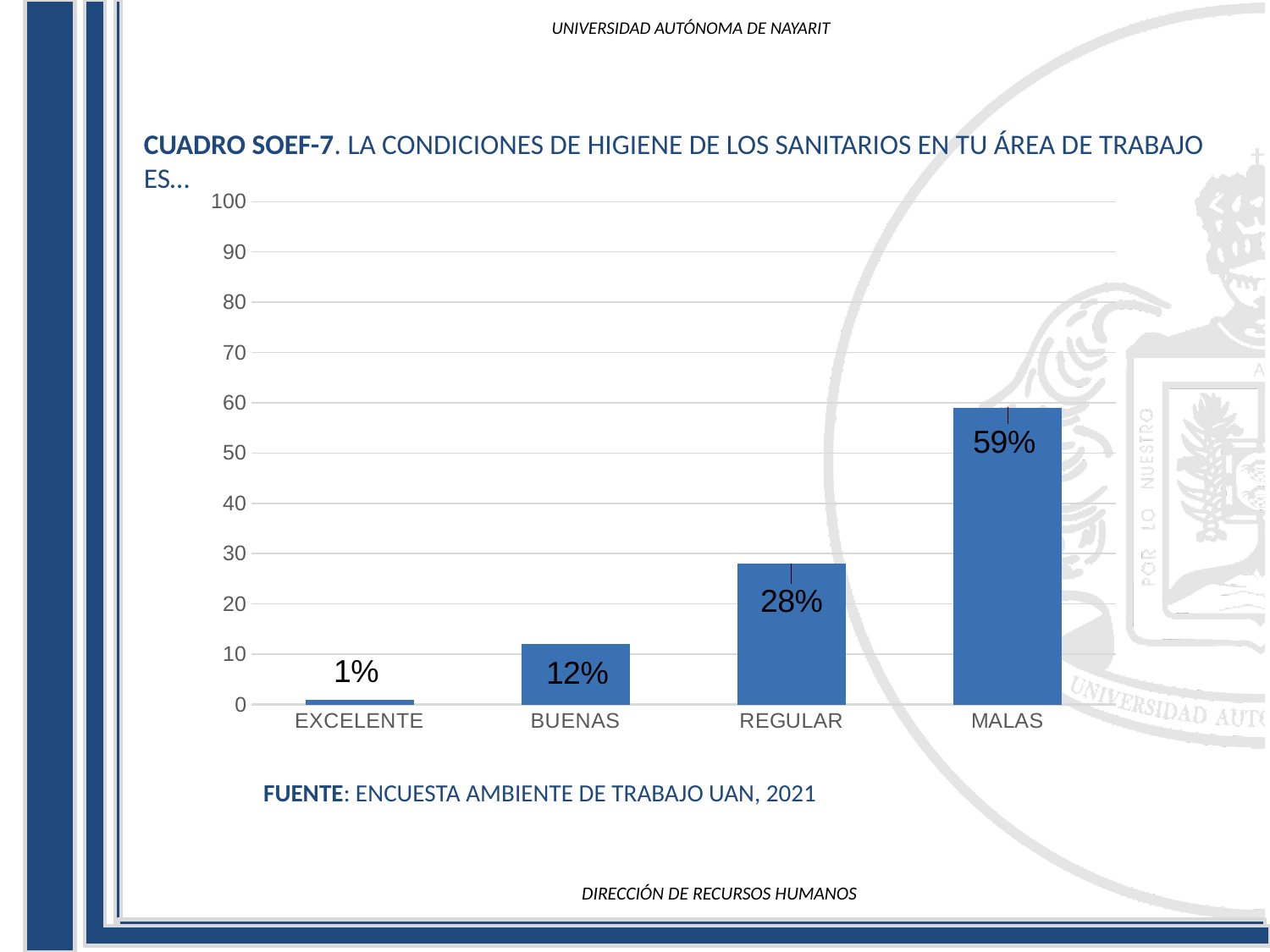
What is the value for BUENAS? 12% Do the values rise or fall from left to right along the x axis? rise How many categories are shown on the x axis? 4 What kind of chart is shown on the slide? bar chart Which is larger, the value for BUENAS or the value for REGULAR? REGULAR Which category has the lowest value? EXCELENTE What is the difference between the values for MALAS and REGULAR? 31% What is the value for REGULAR? 28% Which category has the highest value? MALAS Is the value for MALAS greater or less than 50? greater What is the value for MALAS? 59% What is the value for EXCELENTE? 1%